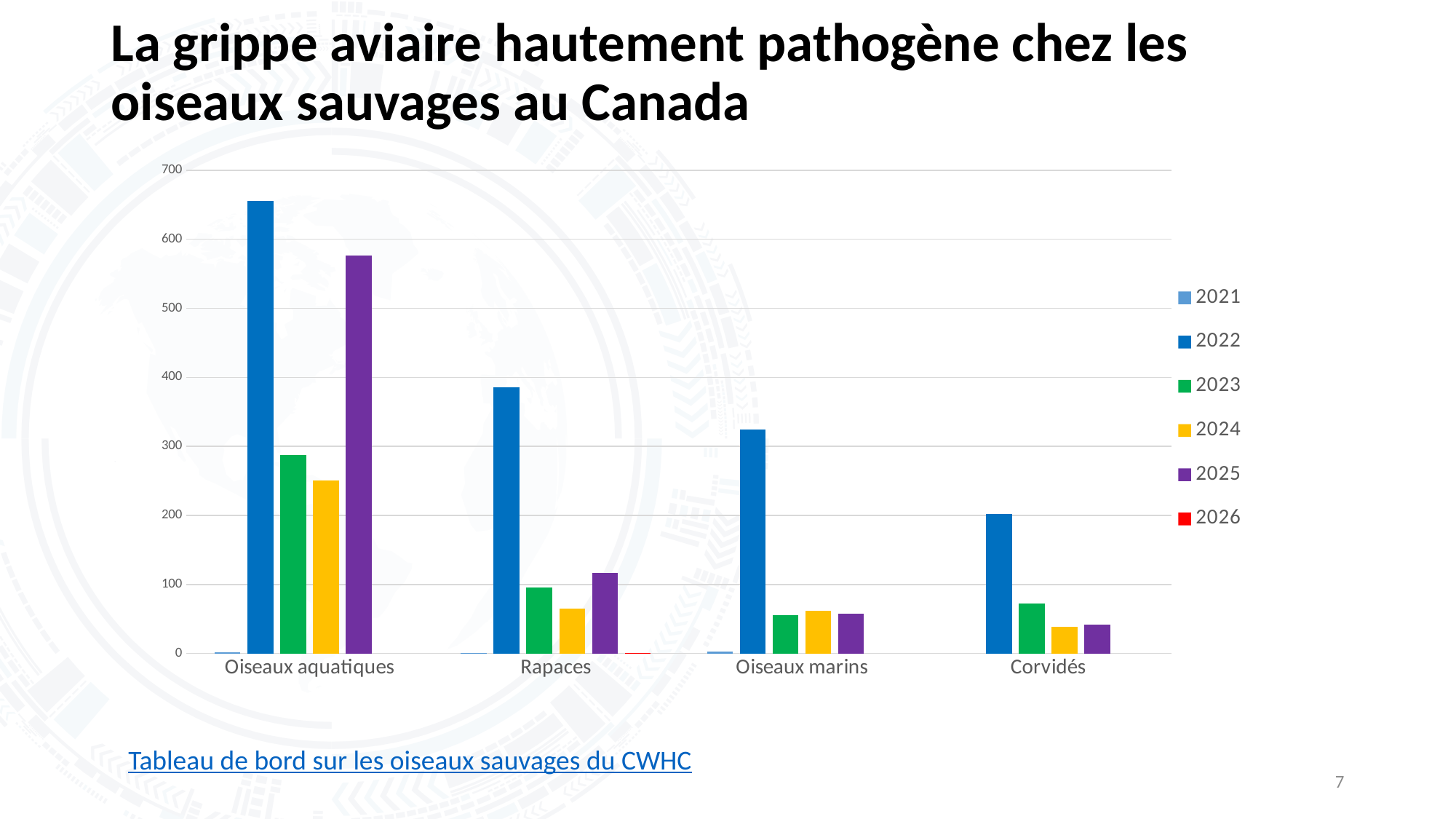
Is the value for 2024 in Rapaces greater or less than 100? less Which year has the highest value for Rapaces? 2022 Which category has the lowest value for 2022? Corvidés Is the value for 2022 in Rapaces greater or less than 400? less Is the value for 2022 in Oiseaux aquatiques greater or less than 600? greater How many bird categories are shown on the x axis? 4 Do the 2022 values rise or fall from Oiseaux aquatiques to Corvidés along the x axis? fall How many series does the legend list? 6 For Oiseaux aquatiques, which is larger, the value for 2023 or the value for 2024? 2023 What kind of chart is shown on the slide? Bar chart Which category has the highest value for 2022? Oiseaux aquatiques